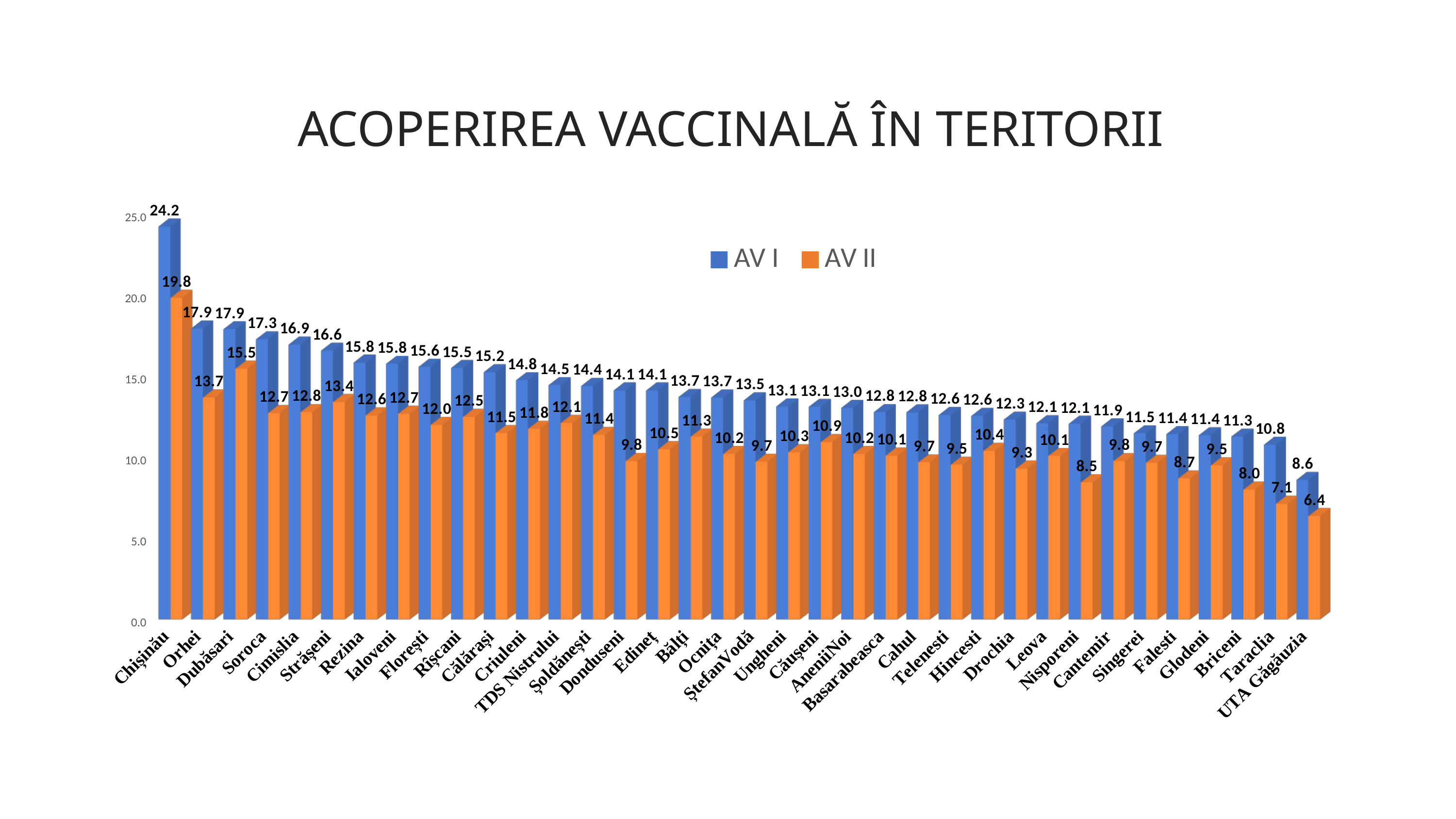
What is the AV II value for Soroca? 12.7 What is the AV I value for Taraclia? 10.8 What is the AV I value for Chișinău? 24.2 What is the difference between the AV I and AV II values for Chișinău? 4.4 What is the difference between the AV I values for Orhei and UTA Găgăuzia? 9.3 Which is larger, the AV II value for Dubăsari or the AV II value for Orhei? Dubăsari How many territories are shown on the x axis? 36 How many series does the legend list? 2 What kind of chart is shown on the slide? bar chart Which territory has the highest AV II value? Chișinău Which territory has the lowest AV I value? UTA Găgăuzia Do the AV I values generally rise or fall from left to right along the x axis? fall